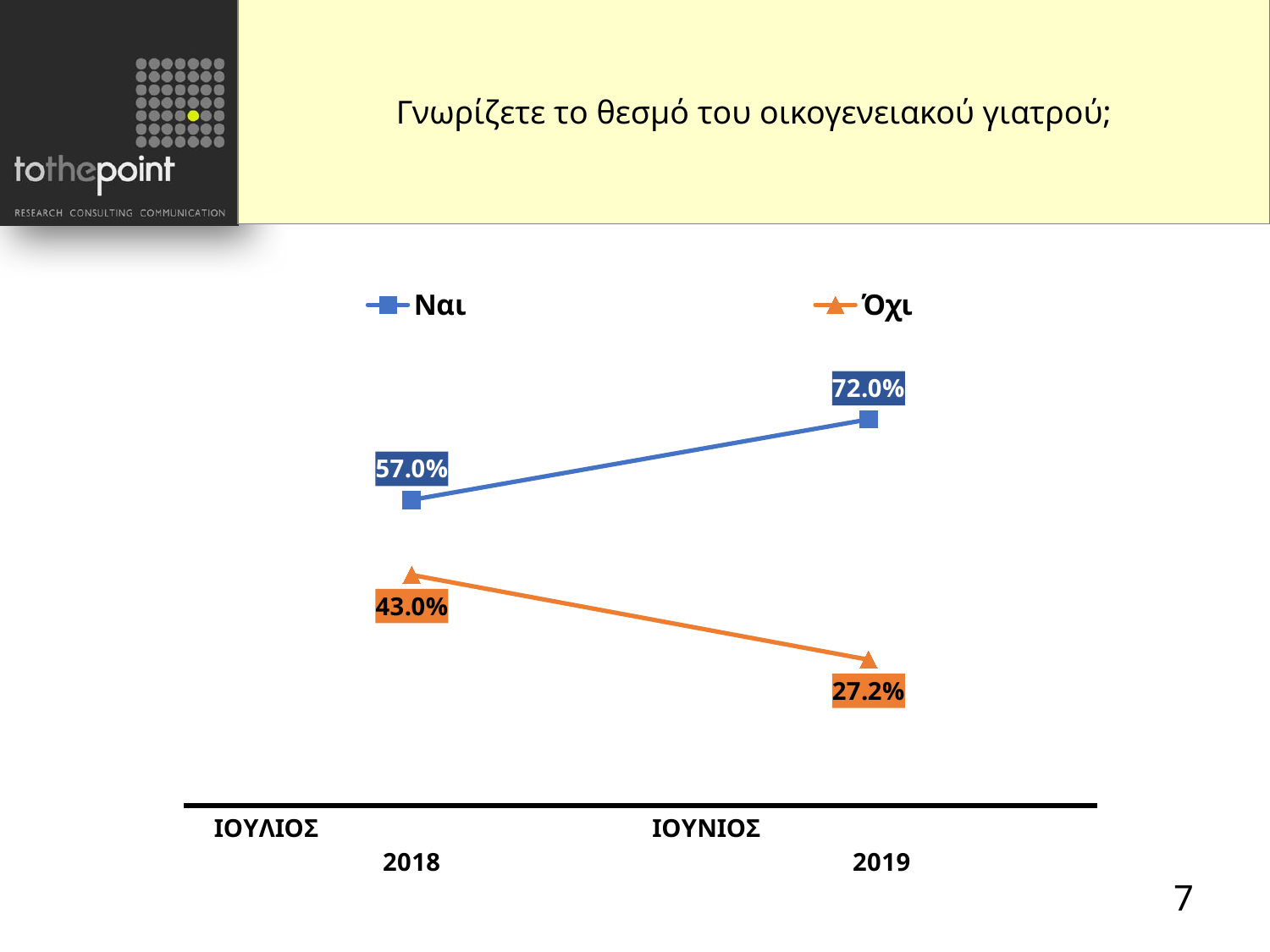
Which series has the higher value in ΙΟΥΛΙΟΣ 2018, Ναι or Όχι? Ναι By how many percentage points did Ναι change from ΙΟΥΛΙΟΣ 2018 to ΙΟΥΝΙΟΣ 2019? 15.0 percentage points What is the value for Όχι in ΙΟΥΝΙΟΣ 2019? 27.2% What is the difference between Ναι and Όχι in ΙΟΥΝΙΟΣ 2019? 44.8 percentage points What is the value for Όχι in ΙΟΥΛΙΟΣ 2018? 43.0% What kind of chart is shown on the slide? Line chart Does the Όχι series rise or fall from ΙΟΥΛΙΟΣ 2018 to ΙΟΥΝΙΟΣ 2019? Fall Does the Ναι series rise or fall from ΙΟΥΛΙΟΣ 2018 to ΙΟΥΝΙΟΣ 2019? Rise What is the value for Ναι in ΙΟΥΛΙΟΣ 2018? 57.0% How many series does the legend list? 2 How many time points are shown on the x axis? 2 What is the value for Ναι in ΙΟΥΝΙΟΣ 2019? 72.0%